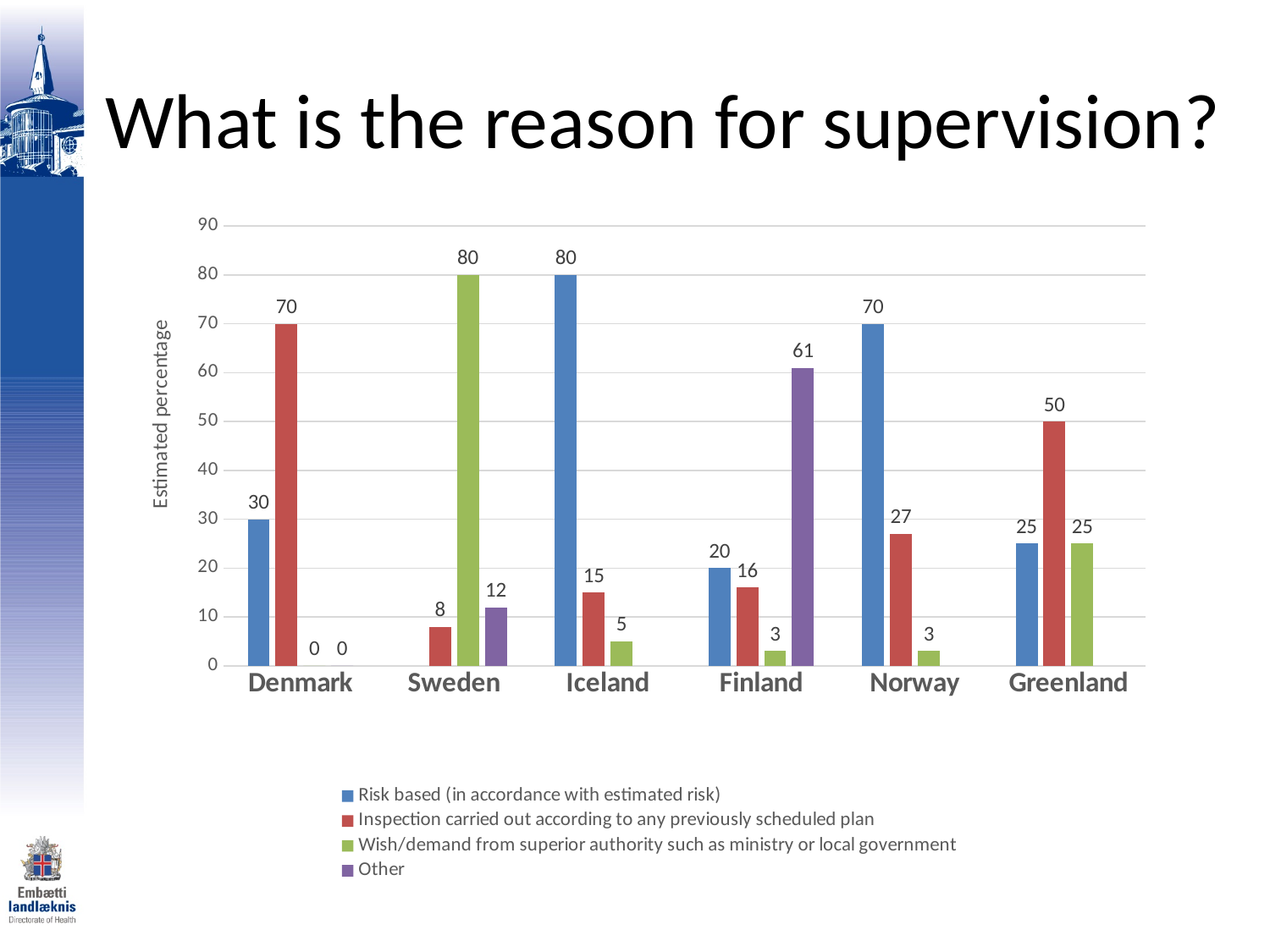
How many series does the legend list? 4 For Finland, which is larger: the 'Risk based' value or the 'Inspection carried out according to any previously scheduled plan' value? Risk based How many countries are shown on the x axis? 6 Which country has the highest value in the 'Risk based (in accordance with estimated risk)' series? Iceland What is the value for Finland in the 'Other' series? 61 What kind of chart is shown on the slide? Bar chart What is the difference between the 'Inspection carried out according to any previously scheduled plan' value and the 'Risk based' value for Greenland? 25 What is the value for Norway in the 'Risk based (in accordance with estimated risk)' series? 70 What is the value for Sweden in the 'Wish/demand from superior authority such as ministry or local government' series? 80 What is the value for Denmark in the 'Inspection carried out according to any previously scheduled plan' series? 70 What is the label of the vertical axis? Estimated percentage Which country has the lowest value in the 'Inspection carried out according to any previously scheduled plan' series? Sweden